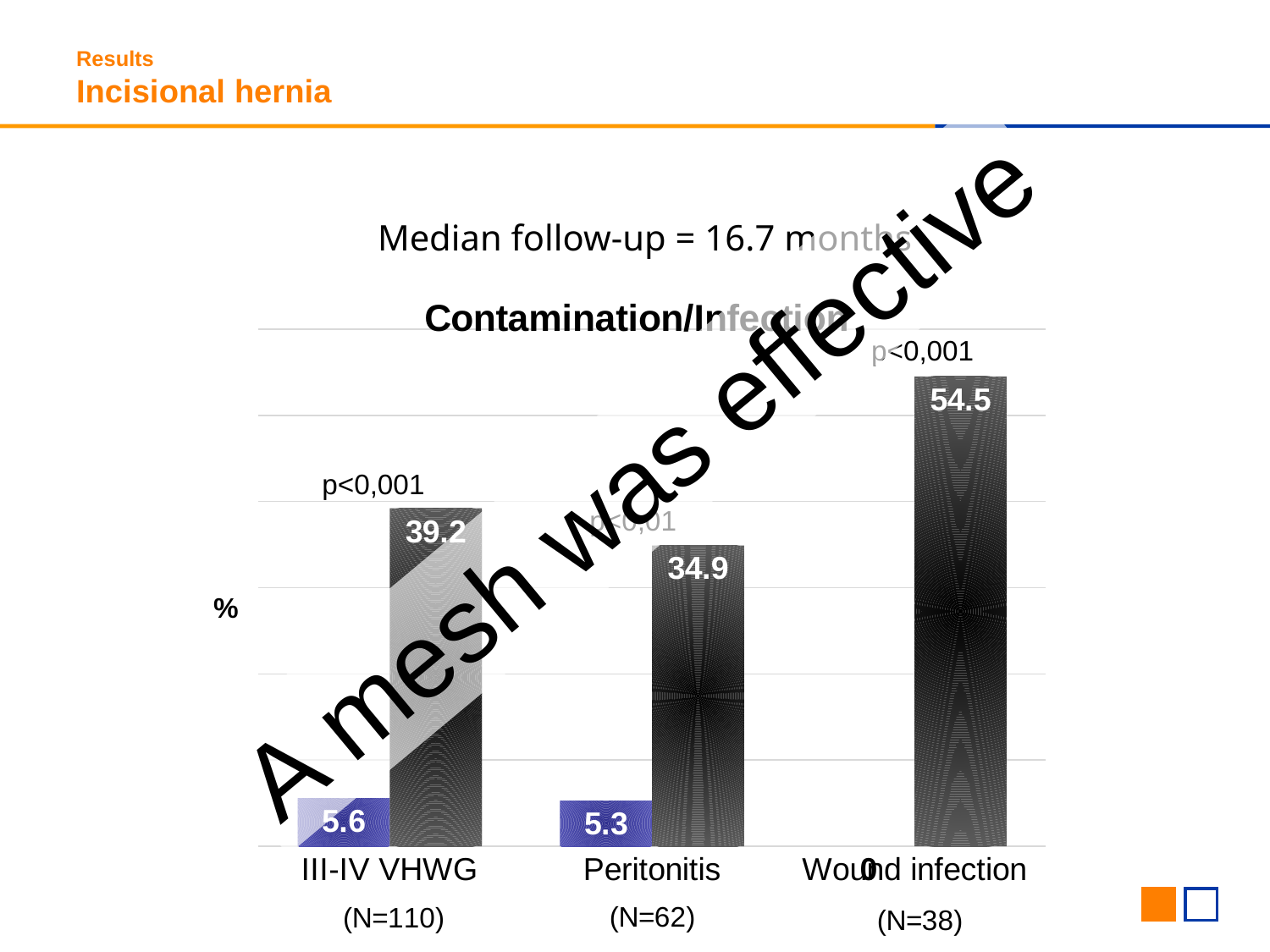
What is the difference between the dark bars for Wound infection and Peritonitis? 19.6 What is the value of the blue bar for III-IV VHWG? 5.6 What is the difference between the dark bar and the blue bar for III-IV VHWG? 33.6 What is the value of the blue bar for Peritonitis? 5.3 Which is larger, the dark bar for III-IV VHWG or the dark bar for Peritonitis? III-IV VHWG What is the value of the dark bar for III-IV VHWG? 39.2 What is the value of the dark bar for Wound infection? 54.5 How many categories are shown on the x axis? 3 What is the title of the chart? Contamination/Infection What kind of chart is shown on the slide? Bar chart Which category has the lowest dark bar? Peritonitis Which category has the highest dark bar? Wound infection